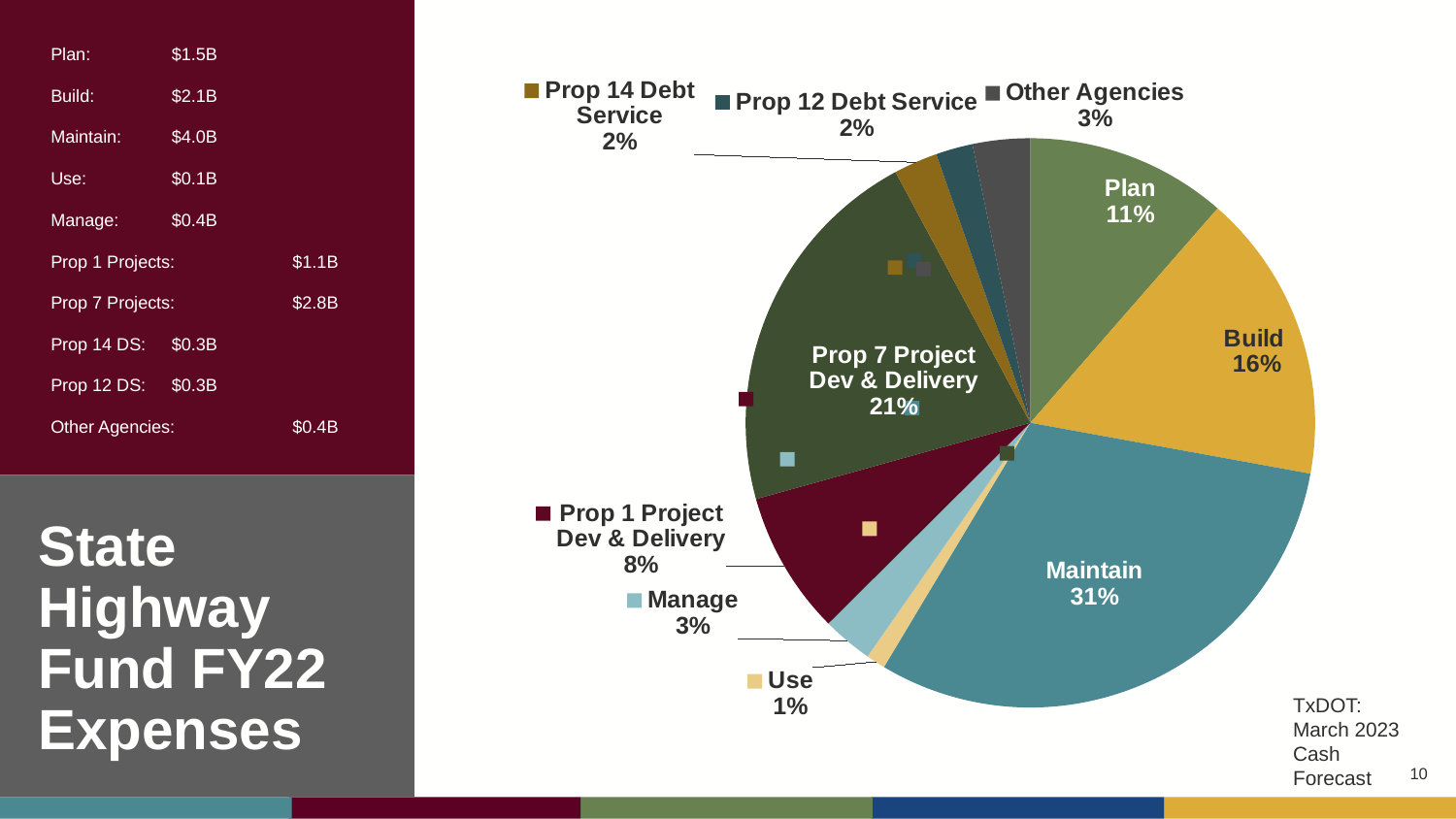
What is the combined share of Prop 14 Debt Service and Prop 12 Debt Service? 4% What percentage is shown for Other Agencies? 3% Which category has the largest slice of the pie? Maintain Which is larger, the Plan slice or the Build slice? Build What kind of chart is shown on the slide? pie chart What percentage is shown for Prop 1 Project Dev & Delivery? 8% Which category has the smallest slice of the pie? Use How many slices does the pie chart have? 10 What percentage is shown for Prop 7 Project Dev & Delivery? 21% What share of the pie does Maintain represent? 31% What percentage is shown for Build? 16% What is the difference in percentage points between Maintain and Build? 15